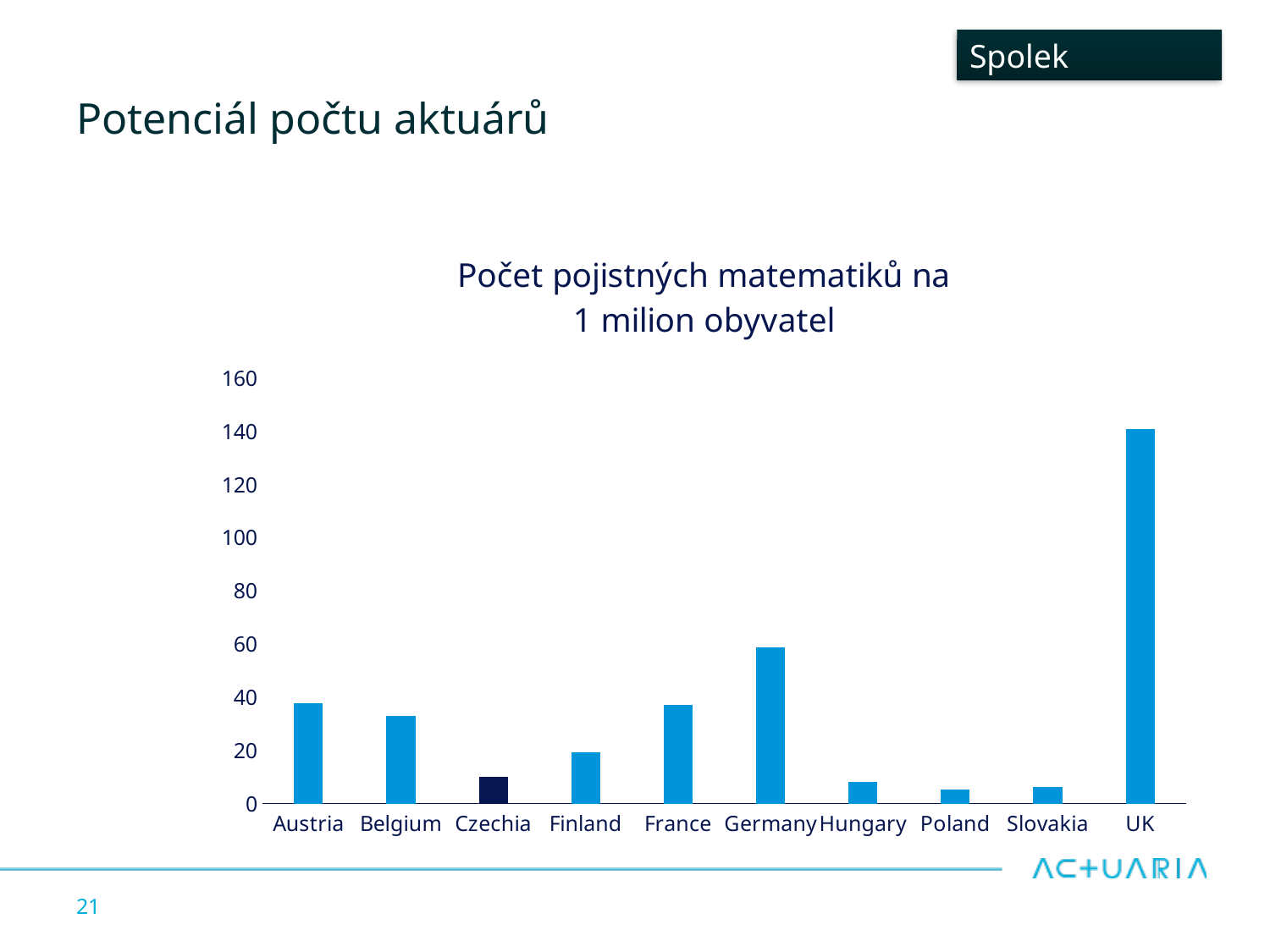
Which has the larger value, Belgium or Finland? Belgium What kind of chart is shown on the slide? bar chart Which country's bar is drawn in a different (dark navy) colour from the others? Czechia Is the value for Poland greater or less than 20? less Which country has the highest value in the chart? UK Is the value for UK greater or less than 120? greater Is the value for Czechia greater or less than 20? less What is the title of the chart? Počet pojistných matematiků na 1 milion obyvatel How many countries are shown on the x axis of the chart? 10 Which has the larger value, Germany or France? Germany